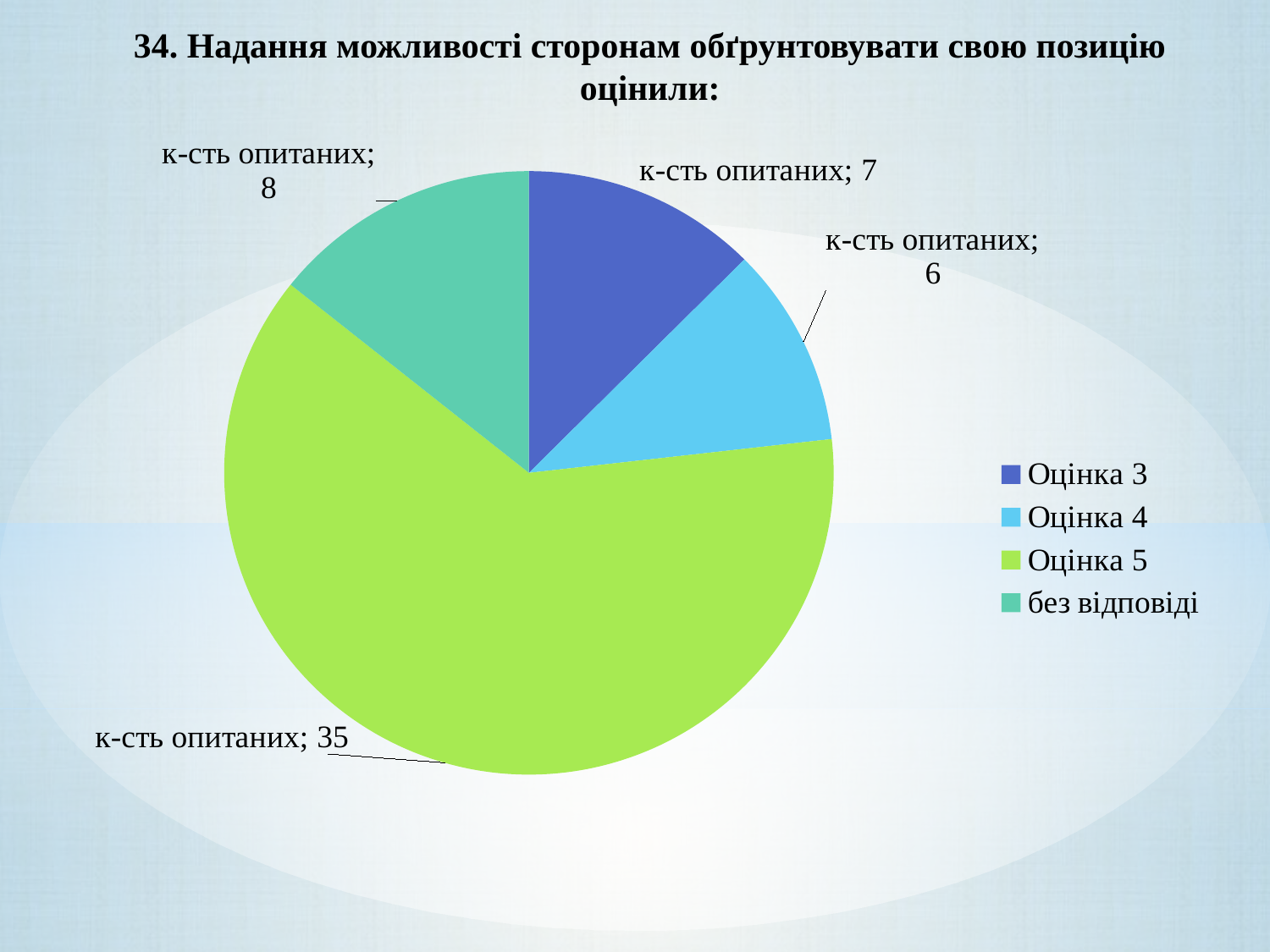
How many respondents gave the rating "Оцінка 5"? 35 What is the difference between the number of respondents for "Оцінка 5" and "без відповіді"? 27 How many categories does the pie chart have? 4 What share of the pie does the "Оцінка 5" slice represent? 62.5% What is the total number of respondents across all slices of the pie? 56 How many respondents gave the rating "Оцінка 3"? 7 How many respondents gave the rating "Оцінка 4"? 6 What kind of chart is shown on the slide? pie chart Which category has the smallest slice of the pie? Оцінка 4 How many respondents are in the "без відповіді" category? 8 Which is larger: the value for "Оцінка 3" or the value for "Оцінка 4"? Оцінка 3 Which category has the largest slice of the pie? Оцінка 5